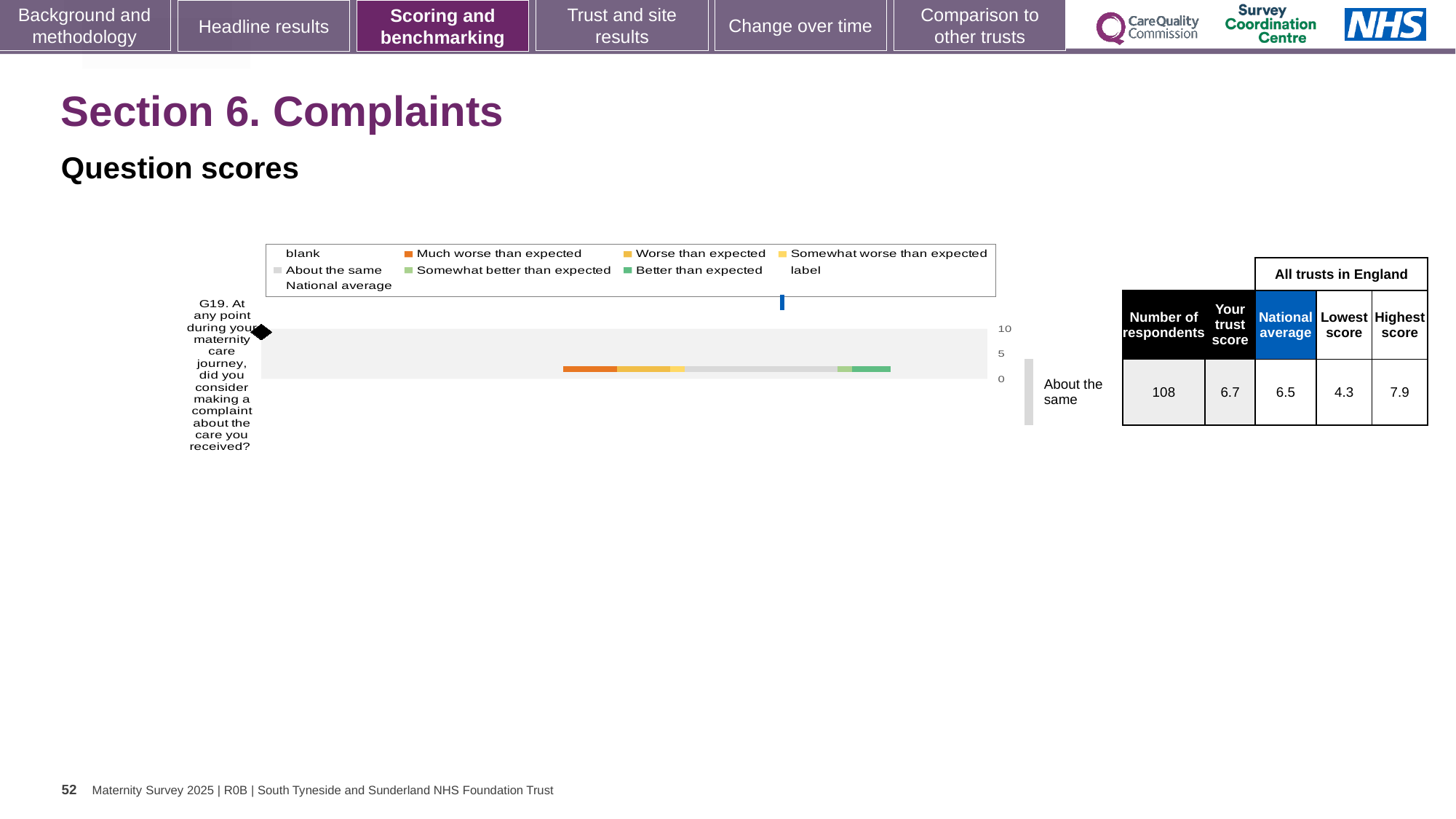
What kind of chart is shown on the slide? bar chart What is the national average for G19 shown in the table beside the chart? 6.5 Which question code is plotted in the chart? G19 Which benchmark category is the trust's G19 score placed in? About the same Which is larger for G19: the trust score or the national average? trust score How many respondents answered G19 according to the table beside the chart? 108 Is the national average marker for G19 greater or less than 5 on the chart axis? greater What is the lowest score across all trusts in England for G19? 4.3 What is the difference between the highest score and the lowest score for G19 in the table beside the chart? 3.6 What is the highest tick value shown on the chart's axis? 10 What is the trust score for G19 shown in the table beside the chart? 6.7 How many survey questions are plotted in the chart? 1